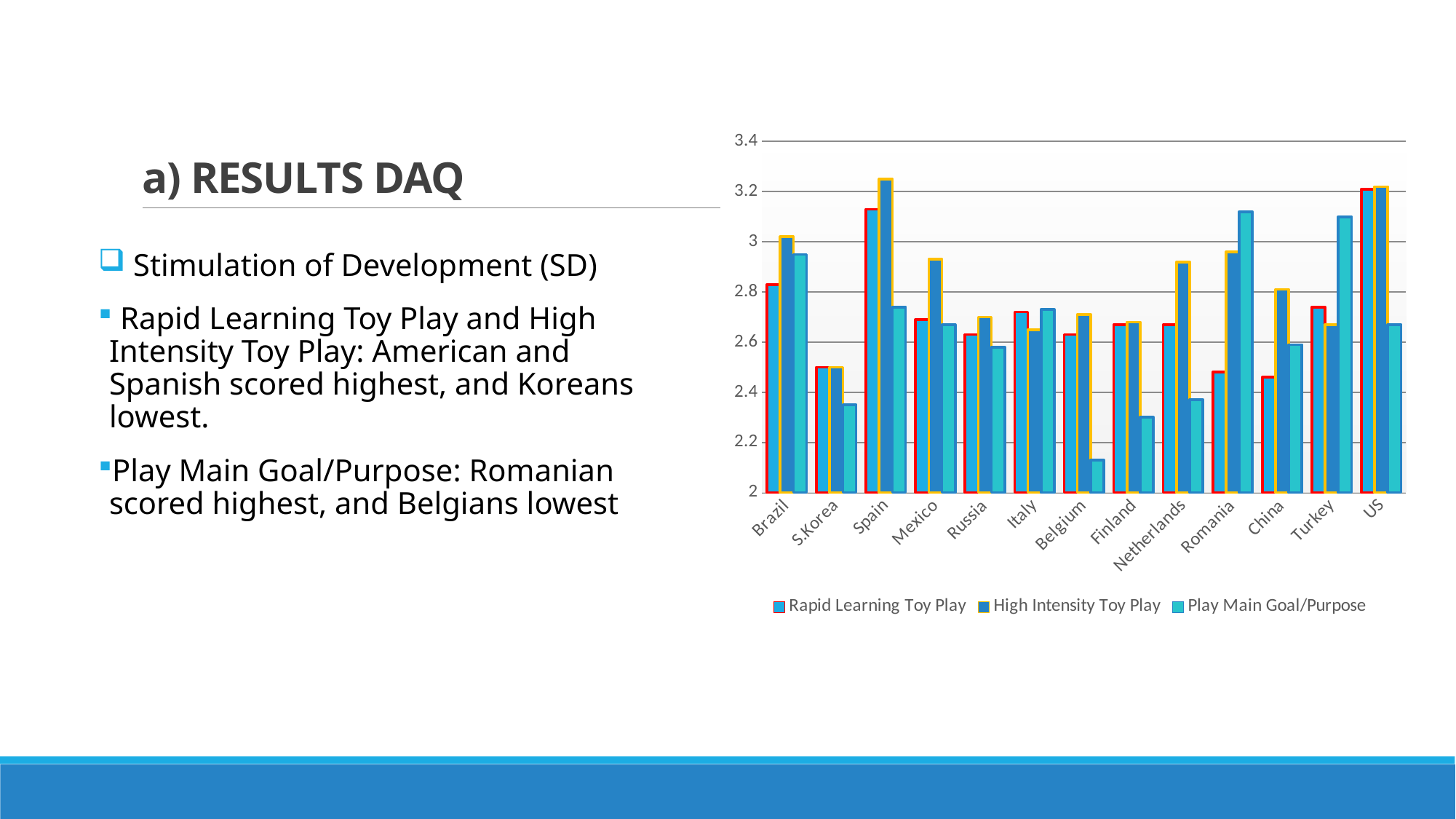
Which country has the lowest value for High Intensity Toy Play? S.Korea Is the High Intensity Toy Play value for Spain greater or less than 3.2? greater Which is larger for Rapid Learning Toy Play: Brazil or Spain? Spain Is the Rapid Learning Toy Play value for Brazil greater or less than 2.8? greater How many series does the chart's legend list? 3 Which country has the highest value for Rapid Learning Toy Play? US Is the Play Main Goal/Purpose value for Turkey greater or less than 3? greater How many countries are shown on the x axis of the chart? 13 Which country has the lowest value for Play Main Goal/Purpose? Belgium What kind of chart is shown on the slide? bar chart Which series is listed first in the chart's legend? Rapid Learning Toy Play